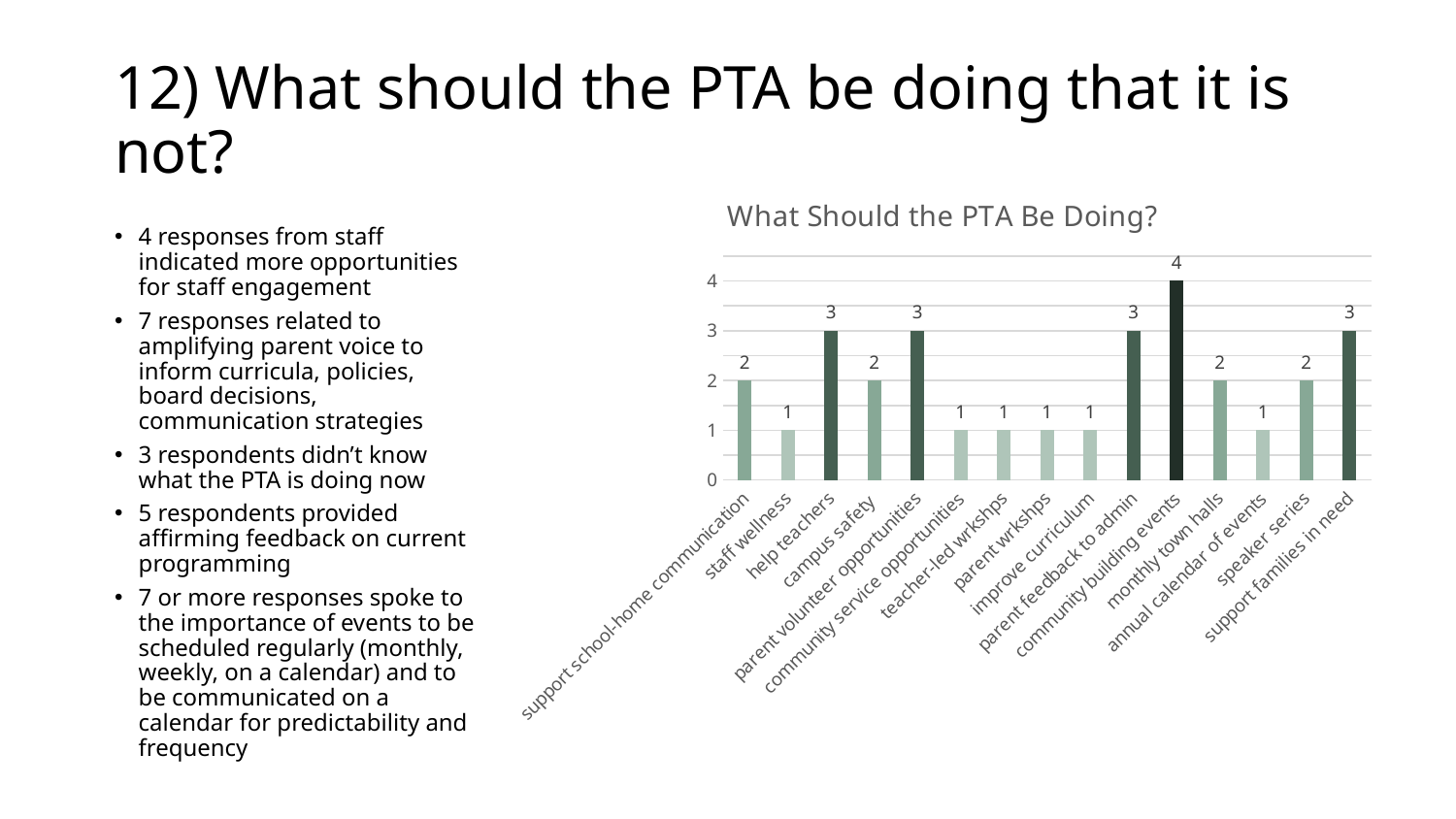
What is the difference between the values for community building events and campus safety? 2 What is the title of the chart? What Should the PTA Be Doing? What is the value for staff wellness? 1 Which is larger, the value for parent feedback to admin or the value for improve curriculum? parent feedback to admin What is the value for community building events? 4 What is the value for monthly town halls? 2 What is the difference between the values for support families in need and annual calendar of events? 2 What is the value for help teachers? 3 What type of chart is shown on the slide? bar chart How many categories are shown on the x axis? 15 Which category has the highest value? community building events Which is larger, the value for speaker series or the value for parent wrkshps? speaker series